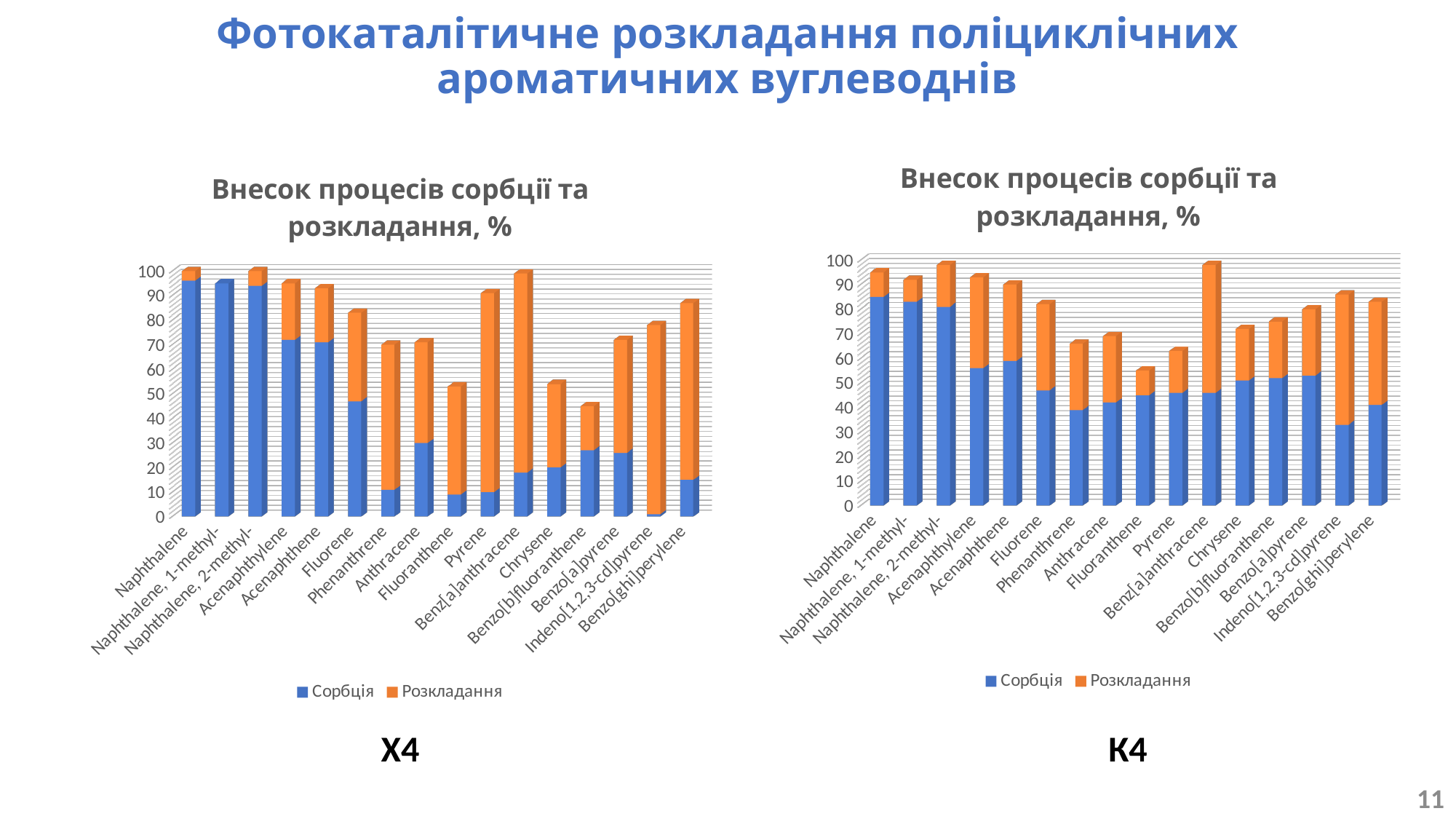
What type of chart is the left chart (X4)? Stacked bar chart In the left chart (X4), which category has the lowest Сорбція value? Indeno[1,2,3-cd]pyrene In the right chart (K4), is the Сорбція value for Indeno[1,2,3-cd]pyrene greater or less than 40? less How many categories are shown on the x axis of the left chart (X4)? 16 What are the two legend entries of the left chart (X4)? Сорбція and Розкладання In the right chart (K4), is the Сорбція value for Naphthalene greater or less than 80? greater In the left chart (X4), is the Сорбція value for Naphthalene greater or less than 90? greater In the right chart (K4), which category has the lowest Сорбція value? Indeno[1,2,3-cd]pyrene How many series does the legend of the right chart (K4) list? 2 In the right chart (K4), which has the larger Розкладання value: Benz[a]anthracene or Naphthalene? Benz[a]anthracene In the left chart (X4), which has the larger Сорбція value: Naphthalene or Fluorene? Naphthalene